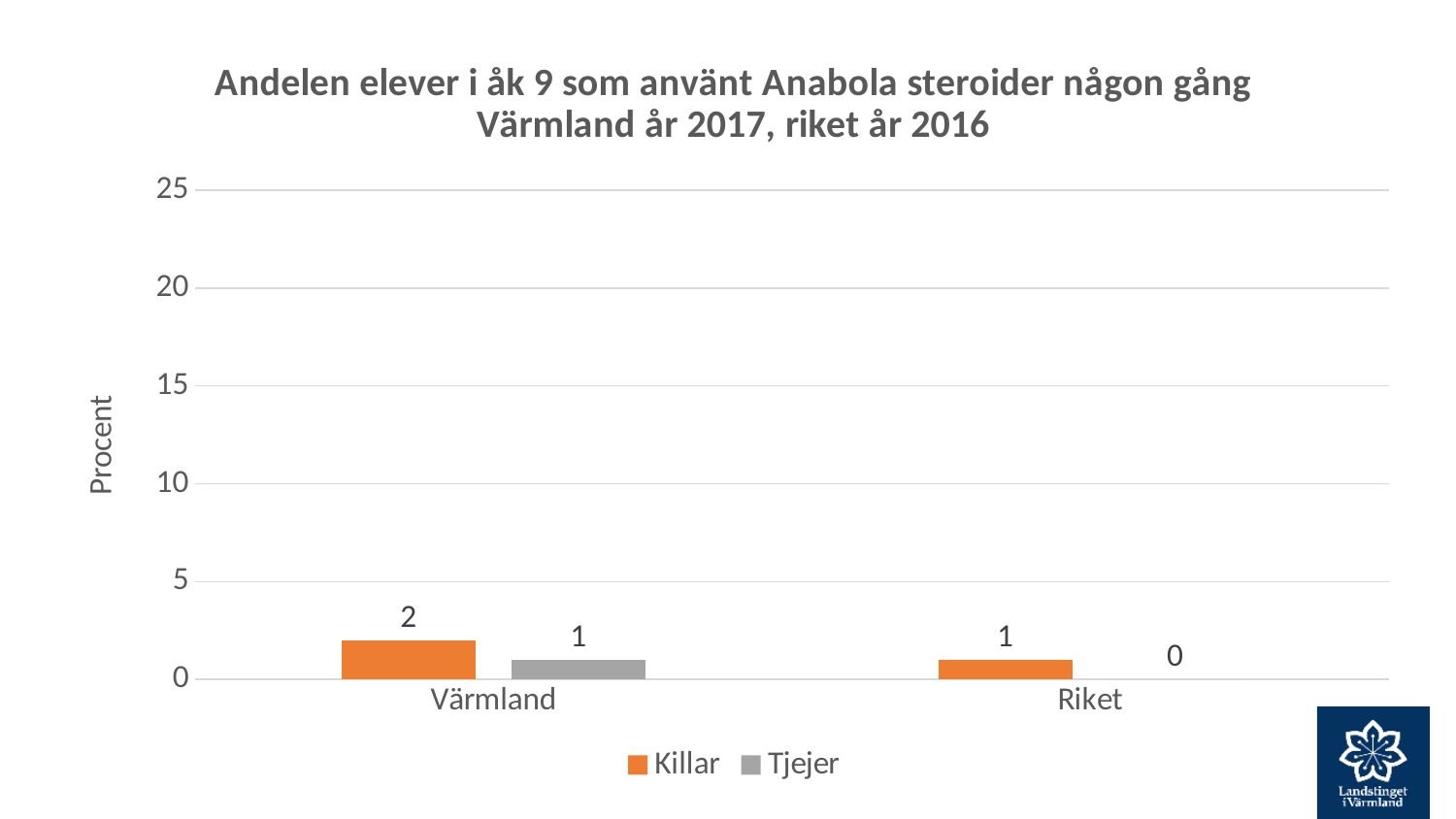
What is the value for Tjejer in Riket? 0 Is the value for Killar in Värmland greater or less than 5? less What is the value for Killar in Värmland? 2 How many series does the legend list? 2 Which category has the highest value for Killar? Värmland Which is larger, the Killar value in Värmland or the Killar value in Riket? Värmland What is the difference between the Killar value and the Tjejer value in Värmland? 1 What is the value for Tjejer in Värmland? 1 Which category has the lowest value for Tjejer? Riket What kind of chart is shown on the slide? bar chart What is the value for Killar in Riket? 1 How many categories are shown on the x axis? 2